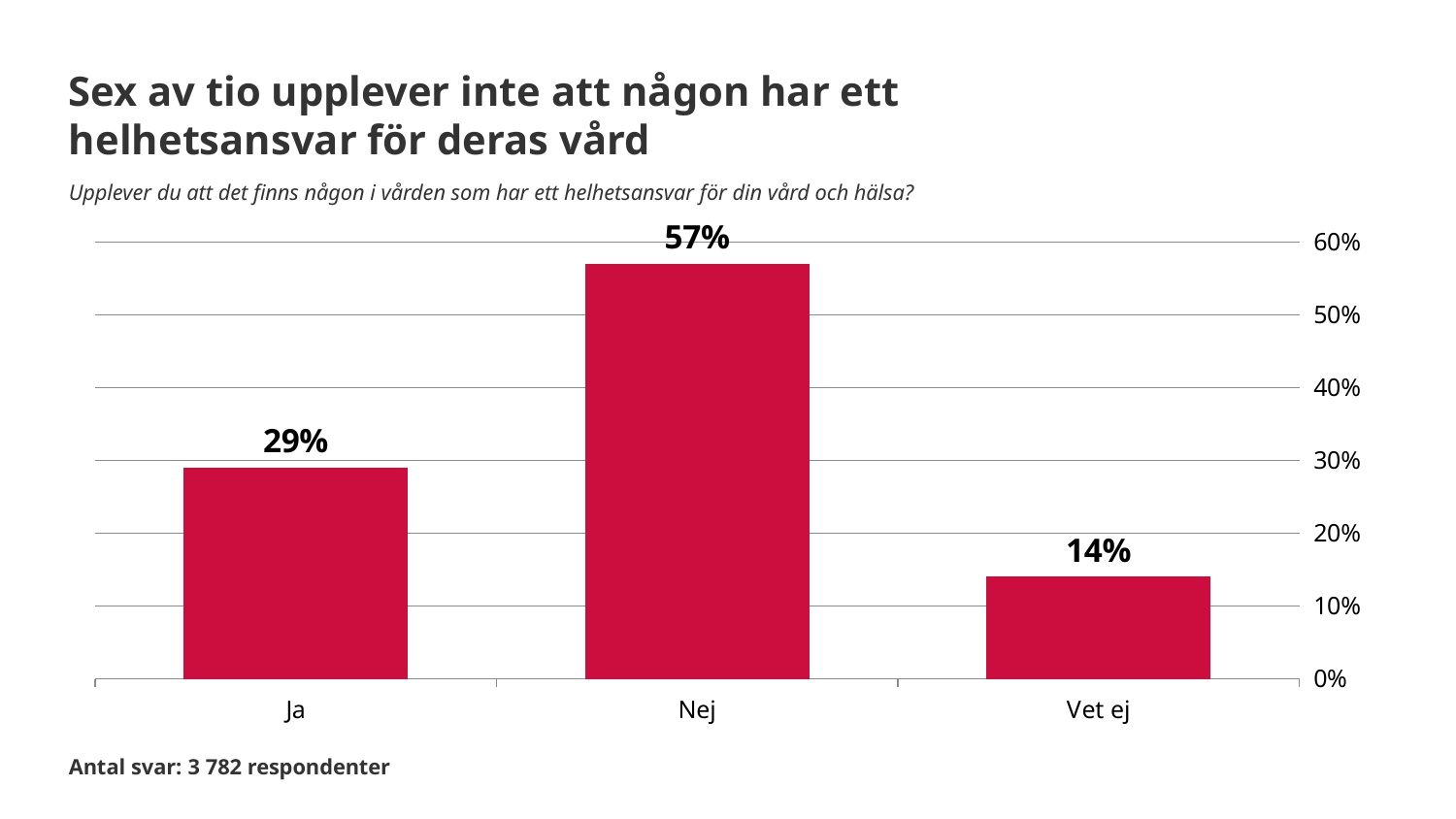
What is the value for Nej? 57% What kind of chart is shown on the slide? bar chart Is the value for Nej greater or less than 50%? greater What is the difference between the values for Ja and Vet ej? 15% Which category has the lowest value? Vet ej How many respondents answered the survey, according to the note below the chart? 3 782 What is the value for Ja? 29% Which is larger, the value for Ja or the value for Vet ej? Ja Which category has the highest value? Nej What is the value for Vet ej? 14% How many categories are shown on the x axis? 3 What is the difference between the values for Nej and Ja? 28%